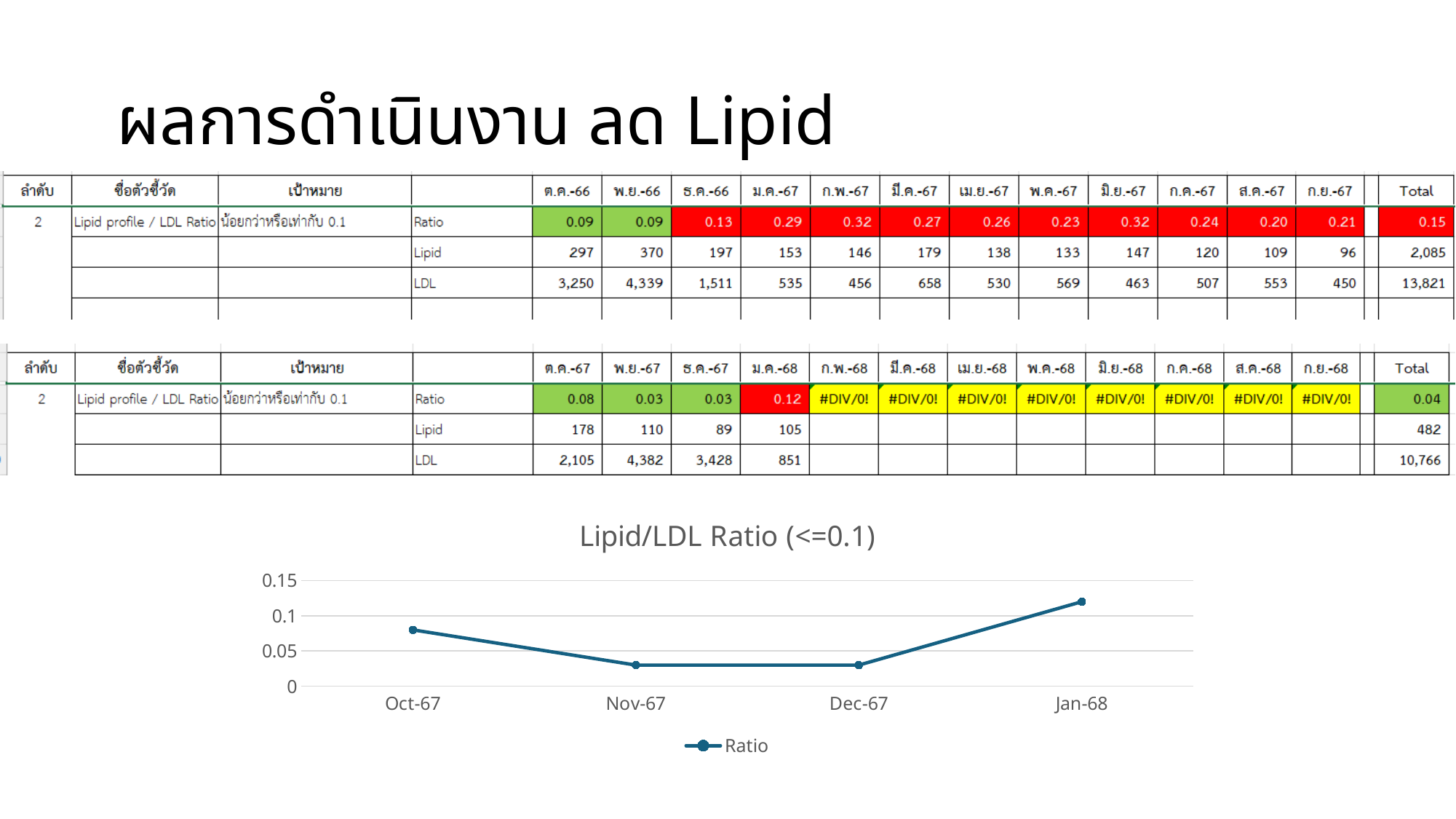
Is the Ratio value for Jan-68 greater or less than 0.1? greater Is the Ratio value for Oct-67 greater or less than 0.1? less Is the Ratio value for Nov-67 greater or less than 0.05? less What is the name of the series shown in the chart legend? Ratio Does the Ratio value rise or fall from Dec-67 to Jan-68? rise How many series does the chart legend list? 1 What is the title of the chart? Lipid/LDL Ratio (<=0.1) How many data points are plotted on the chart? 4 Which is larger, the Ratio value for Oct-67 or for Nov-67? Oct-67 What kind of chart is shown on the slide? Line chart Which month has the highest Ratio value on the chart? Jan-68